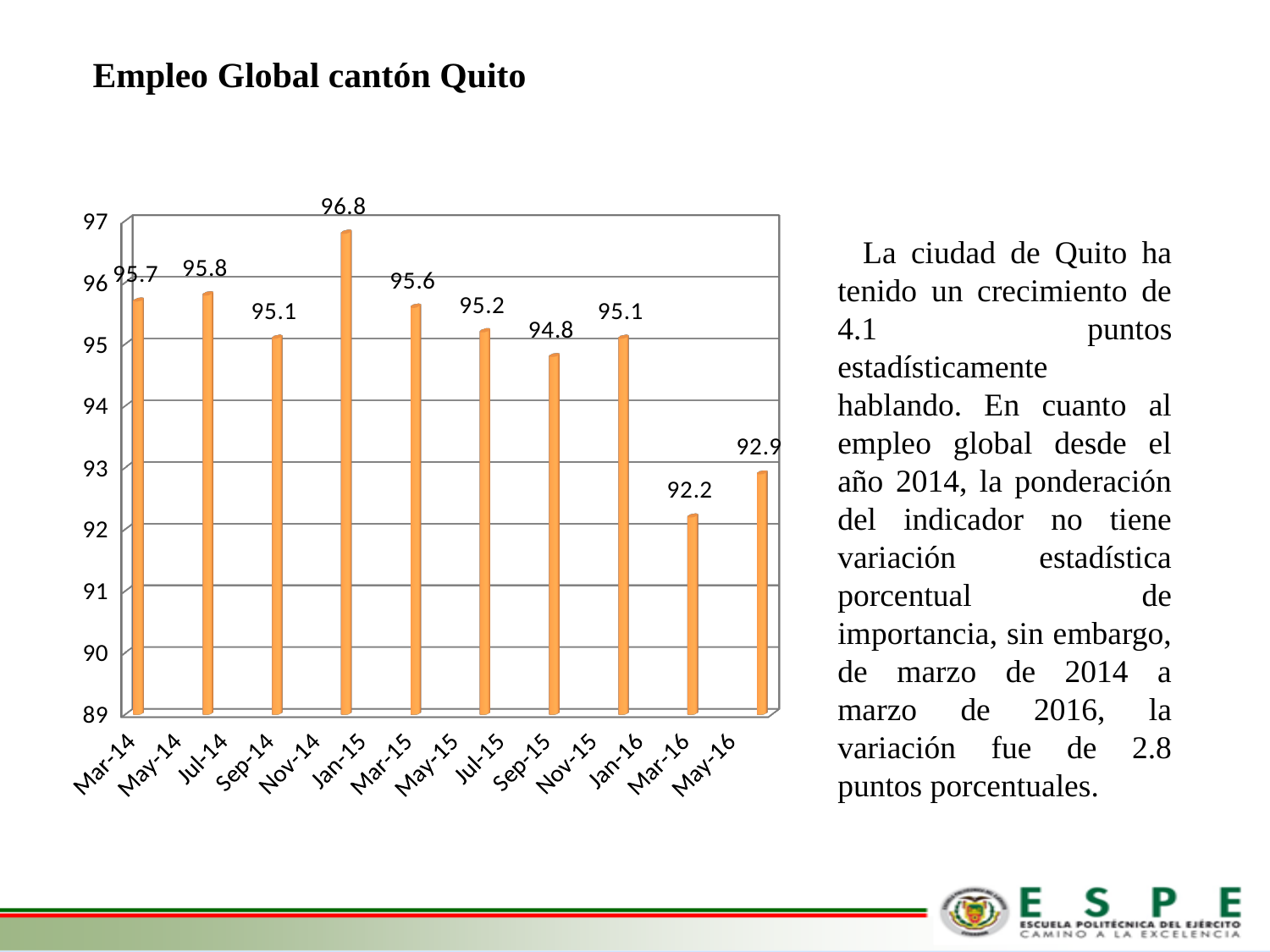
Which is larger, the value of the first bar or the value of the last bar? the first bar (95.7) What is the highest value shown on the chart? 96.8 What is the difference between the highest and lowest values on the chart? 4.6 Overall, do the values rise or fall from the left of the chart to the right? fall What is the lowest value shown on the chart? 92.2 What is the difference between the first bar (95.7) and the last bar (92.9)? 2.8 What kind of chart is shown on the slide? bar chart What is the value of the last (rightmost) bar on the chart? 92.9 Is the value of the second-to-last bar greater or less than 93? less How many bars are plotted on the chart? 10 What is the title of the slide containing the chart? Empleo Global cantón Quito What is the value of the first (leftmost) bar on the chart? 95.7